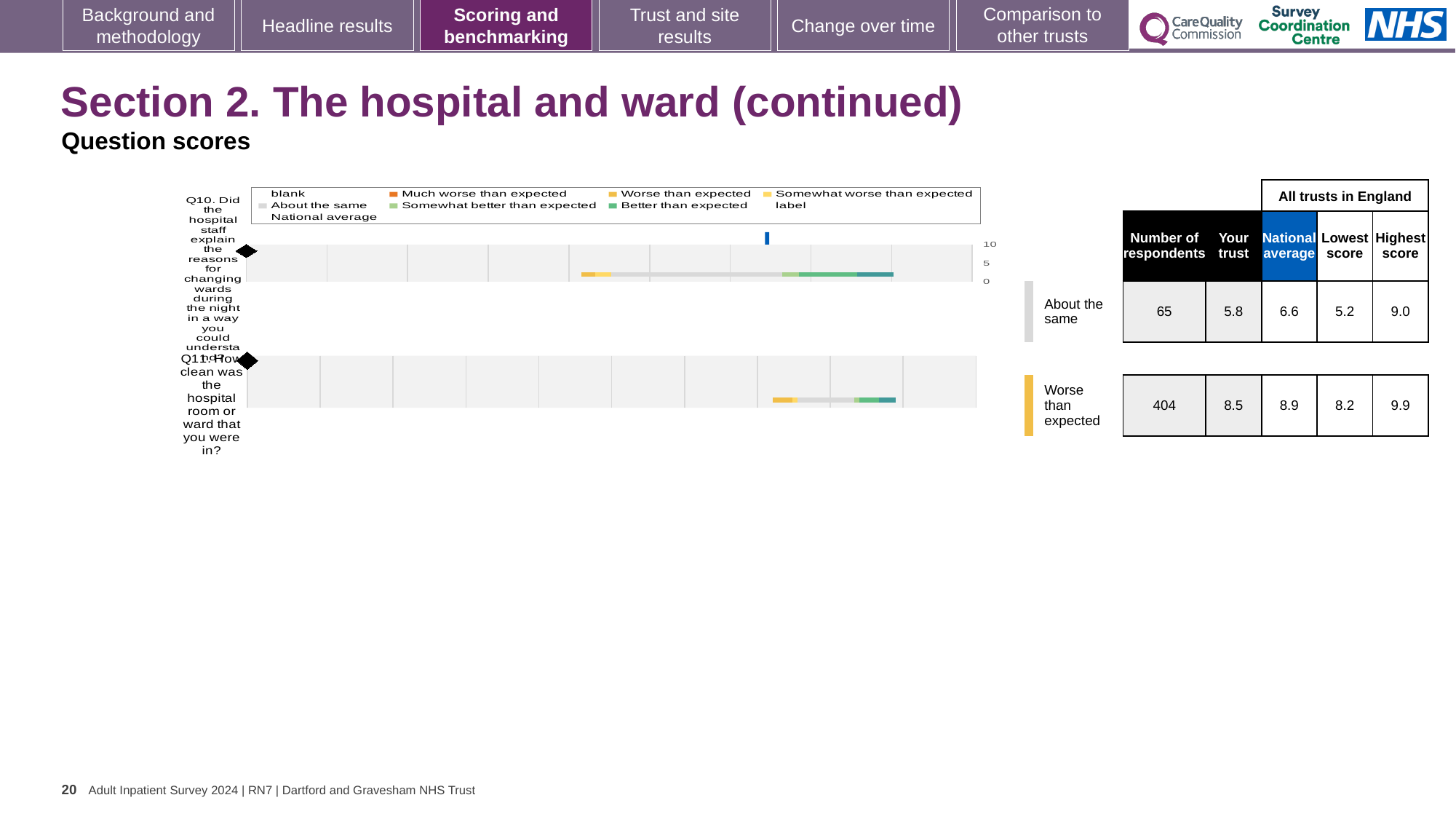
What kind of chart is used to show the question scores for Q10 and Q11? bar chart Which question has the higher 'Your trust' score, Q10 or Q11? Q11 What is the 'Your trust' score for Q10 (explaining reasons for changing wards during the night)? 5.8 What is the highest score across all trusts in England for Q10? 9.0 What is the lowest score across all trusts in England for Q11? 8.2 Which benchmarking category is Q10 placed in? About the same How many questions are plotted in the question scores chart? 2 Is the trust's score for Q10 greater or less than 5 on the chart axis? greater What is the difference between the highest and lowest scores for Q11? 1.7 What is the national average score for Q11 (how clean was the hospital room or ward)? 8.9 How many respondents answered Q11? 404 Which benchmarking category is Q11 placed in? Worse than expected